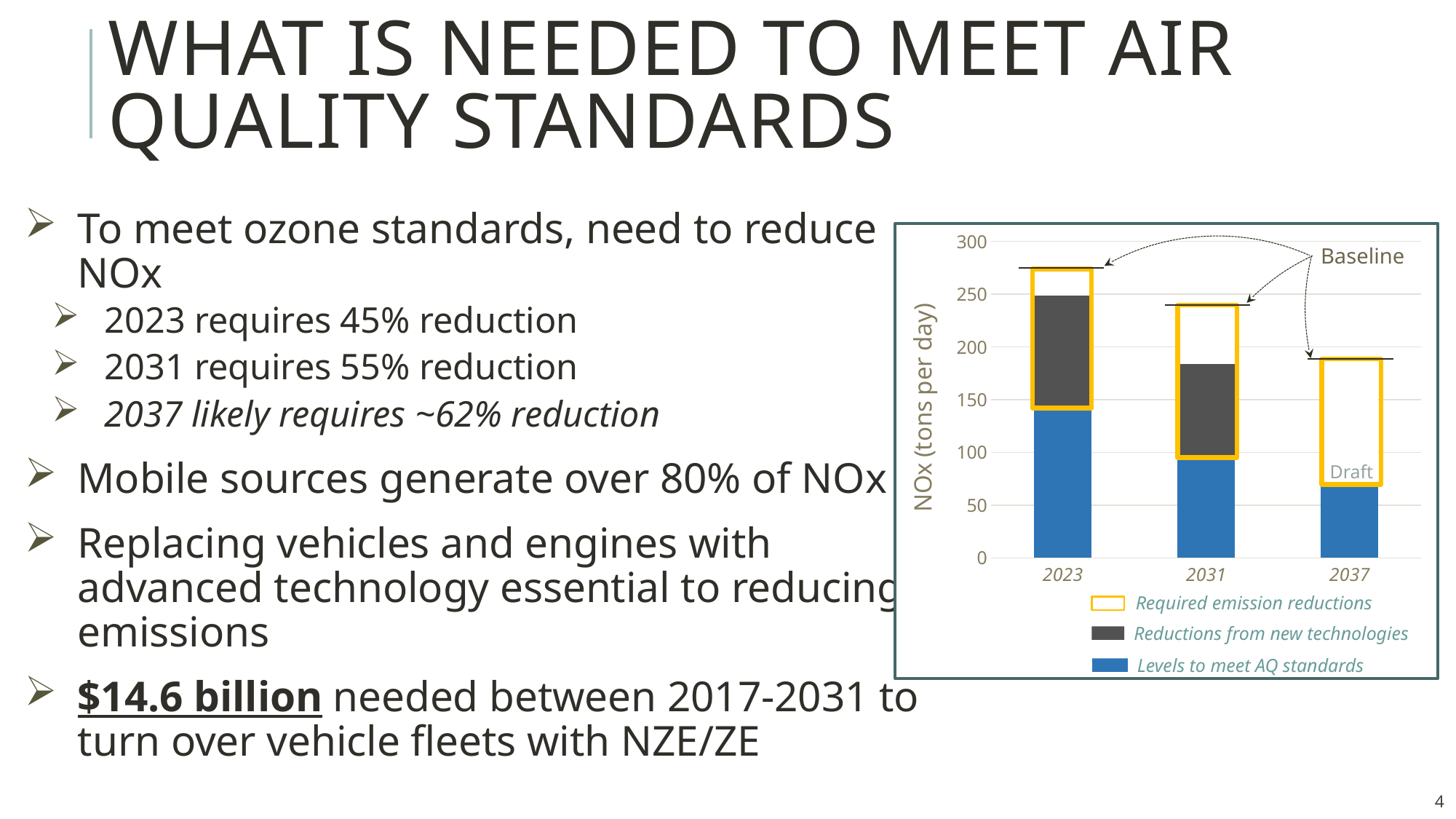
How many year categories are shown on the x axis of the chart? 3 What is the label of the y axis of the chart? NOx (tons per day) Which legend entry is shown in blue? Levels to meet AQ standards What kind of chart is shown on the slide? stacked bar chart Which year has the lowest level to meet AQ standards? 2037 Is the baseline value for 2023 greater or less than 250? greater Is the value for Levels to meet AQ standards in 2037 greater or less than 100? less Which year has the highest baseline NOx level? 2023 Is the baseline value for 2037 greater or less than 200? less Do the baseline NOx levels rise or fall from 2023 to 2037? fall How many series does the chart legend list? 3